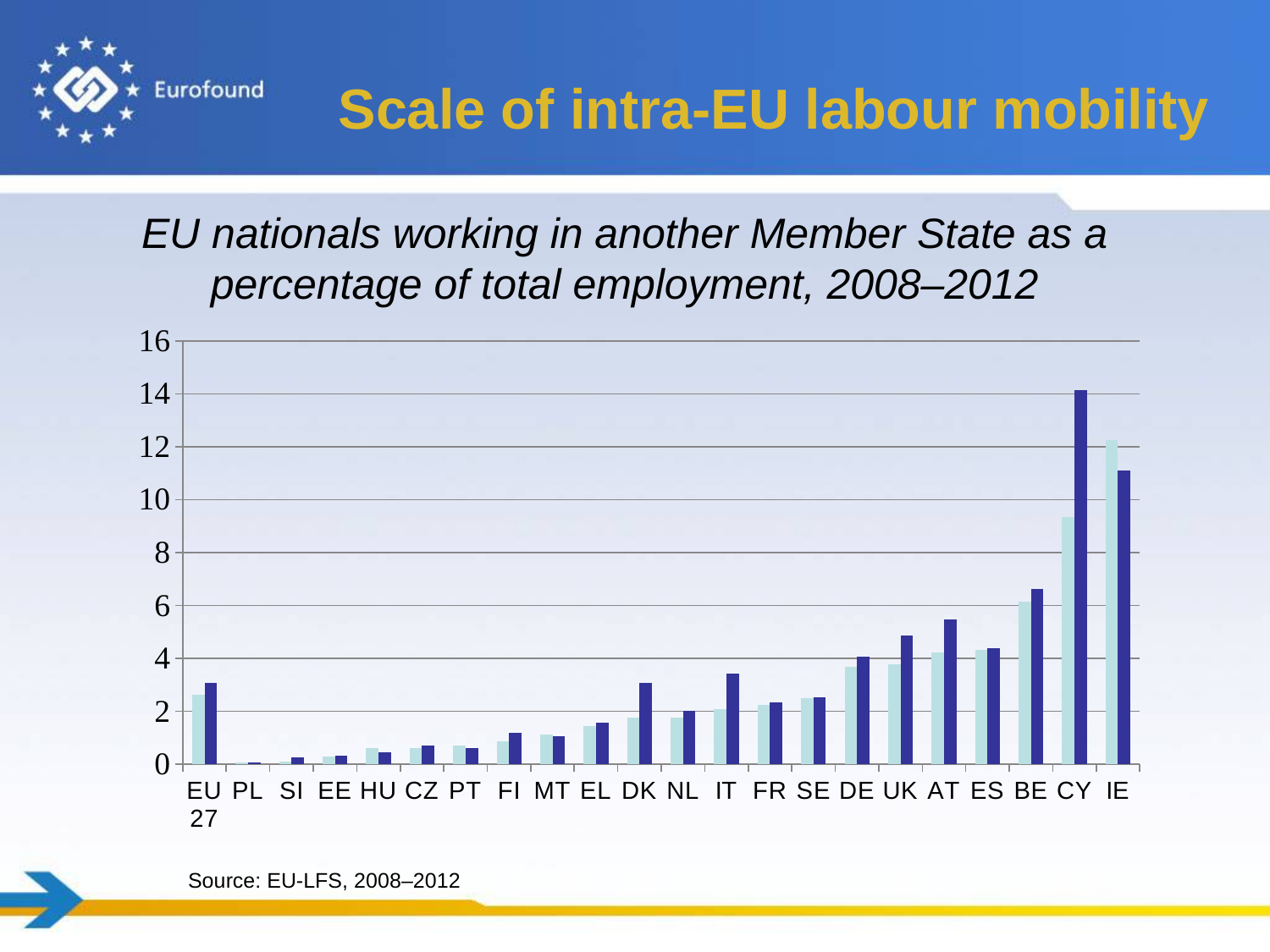
Is the value of the dark blue bar for CY greater or less than 12? greater How many countries/categories are shown along the x axis of the chart? 22 Do the dark blue bars generally rise or fall moving from left to right along the x axis? rise Is the value of the dark blue bar for IT greater or less than 4? less What kind of chart is shown on the slide? bar chart Which has the larger light blue bar, CY or IE? IE Which category has the tallest bar in the chart? CY Is the value of the dark blue bar for IE greater or less than 10? greater Which has the larger dark blue bar, CY or IE? CY Which category has the lowest bars in the chart? PL